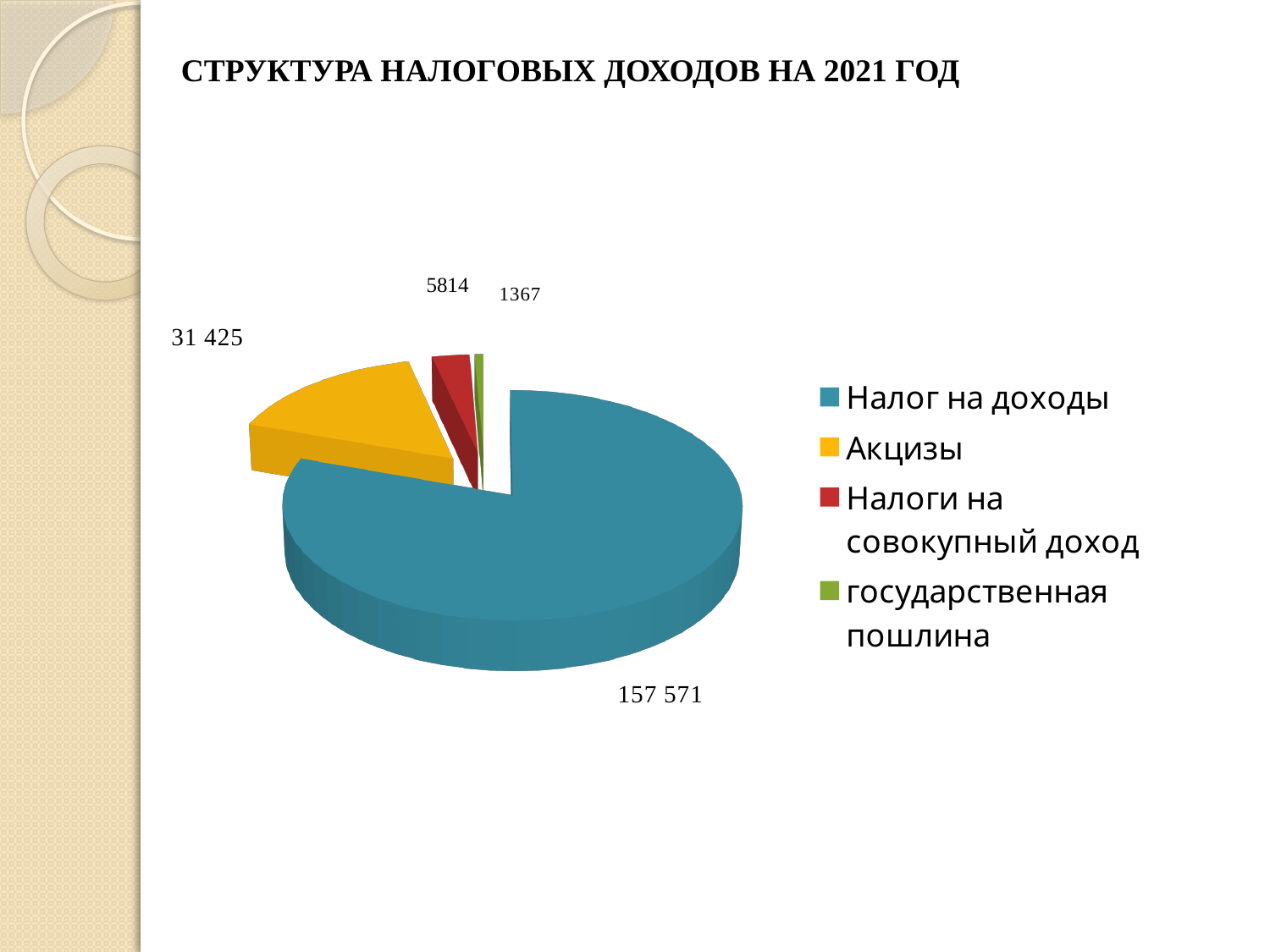
Which category has the largest slice of the pie? Налог на доходы Which category has the smallest slice of the pie? государственная пошлина What kind of chart is shown on the slide? Pie chart What value is shown for государственная пошлина? 1367 How many categories are shown in the pie chart? 4 What is the title of the slide? СТРУКТУРА НАЛОГОВЫХ ДОХОДОВ НА 2021 ГОД What is the difference between the values for Акцизы and Налоги на совокупный доход? 25 611 Which is larger, Налоги на совокупный доход or государственная пошлина? Налоги на совокупный доход What value is shown for Акцизы? 31 425 What is the difference between the values for Налог на доходы and Акцизы? 126 146 What value is shown for Налоги на совокупный доход? 5814 What value is shown for Налог на доходы? 157 571